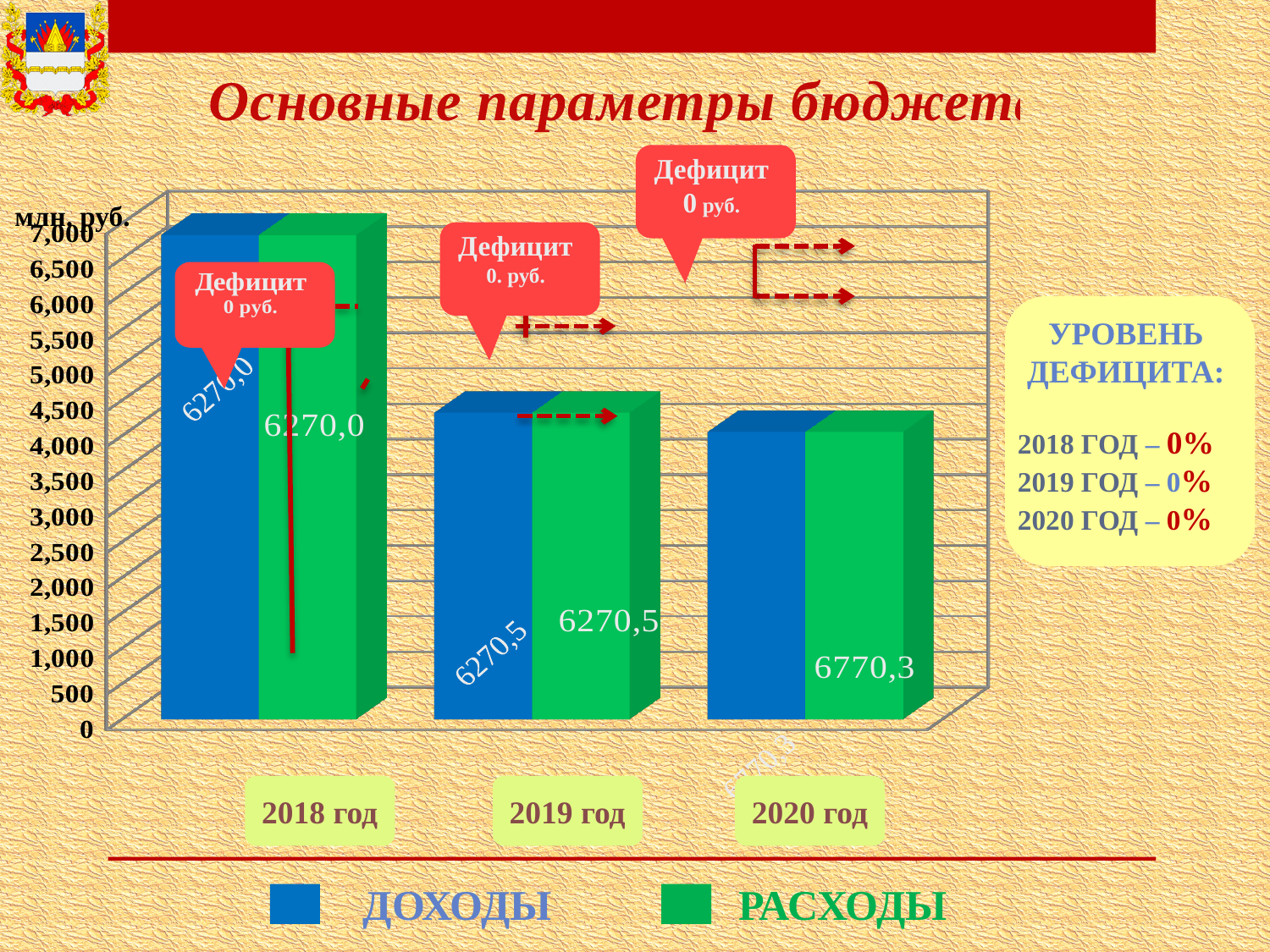
What is the value of РАСХОДЫ for 2020 год? 6770,3 Which colour represents ДОХОДЫ in the chart legend? blue What is the difference between РАСХОДЫ in 2020 год and РАСХОДЫ in 2019 год? 499,8 How many series does the chart legend list? 2 What kind of chart is shown on the slide? bar chart How many years (categories) are shown on the x axis of the chart? 3 What is the value of ДОХОДЫ for 2018 год? 6270,0 What is the value of РАСХОДЫ for 2019 год? 6270,5